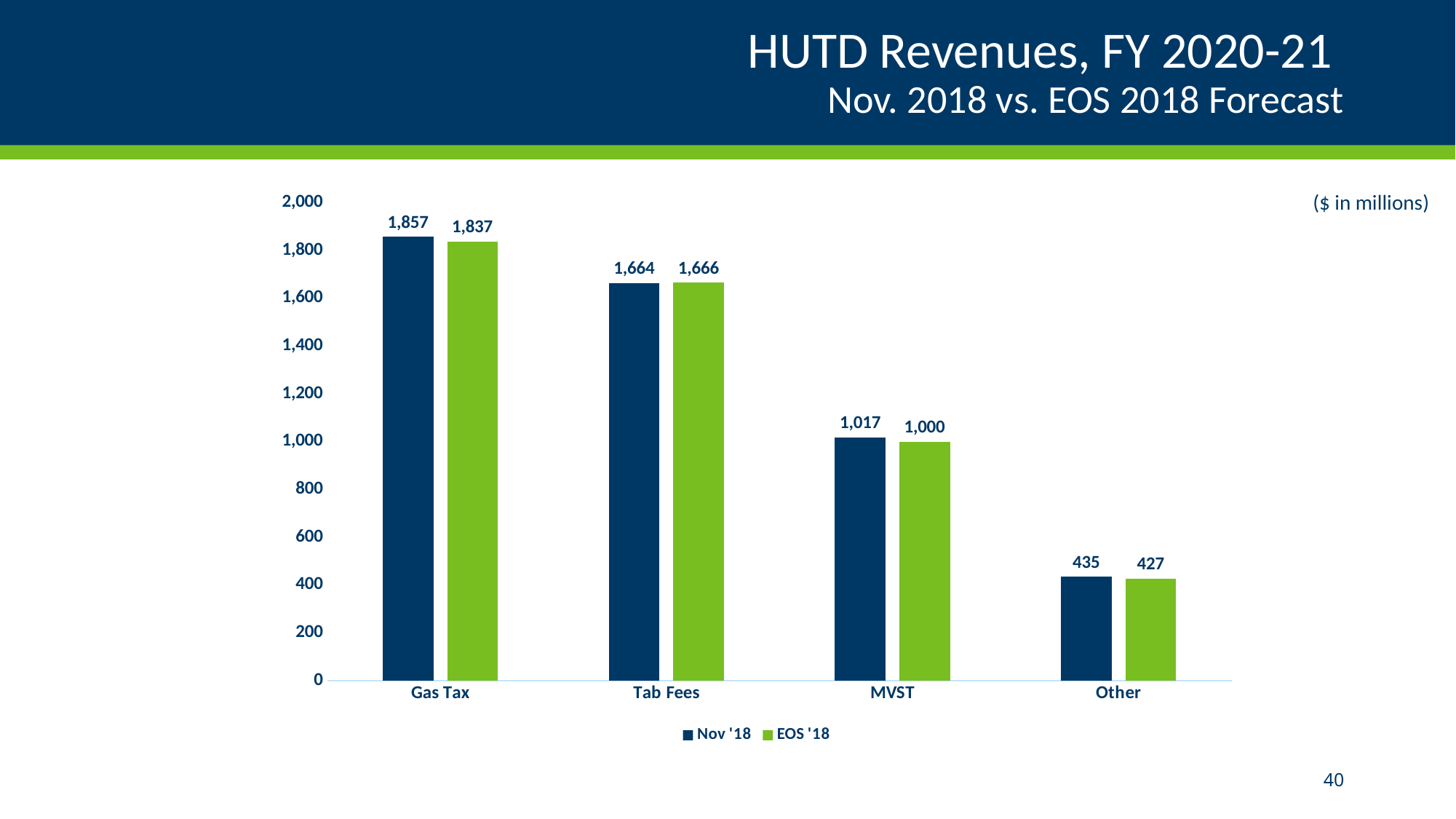
What kind of chart is shown on the slide? Bar chart Which is larger for Tab Fees, the Nov '18 value or the EOS '18 value? EOS '18 What is the Nov '18 value for Gas Tax? 1,857 How many categories are shown on the x axis? 4 How many series does the legend list? 2 What unit is stated for the values on the chart? $ in millions Which category has the highest Nov '18 value? Gas Tax What is the EOS '18 value for MVST? 1,000 What is the difference between the Nov '18 and EOS '18 values for Gas Tax? 20 Which category has the lowest EOS '18 value? Other What is the EOS '18 value for Other? 427 What is the difference between the Nov '18 and EOS '18 values for MVST? 17